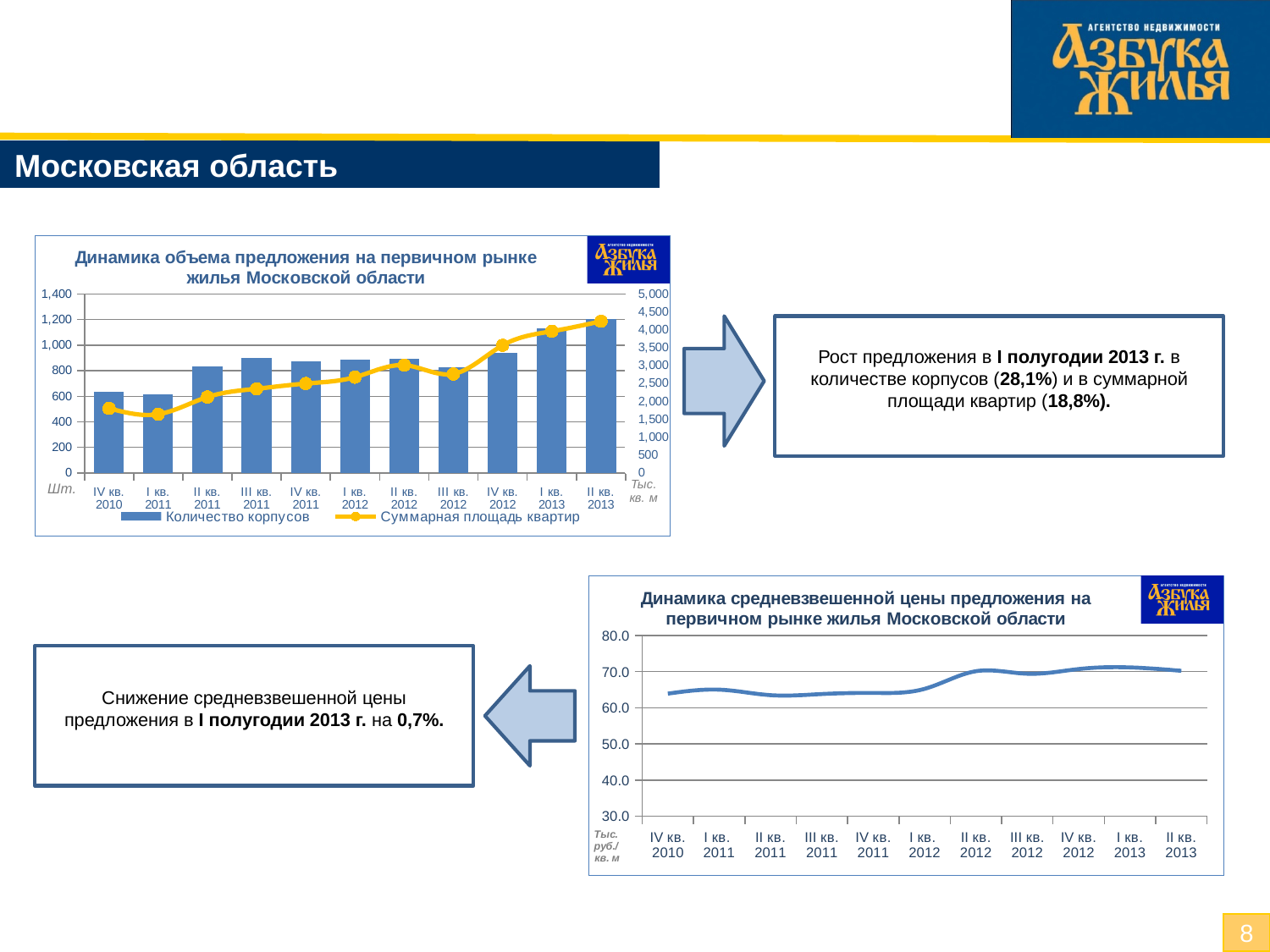
In the top-left chart 'Динамика объема предложения на первичном рынке жилья Московской области', is the 'Количество корпусов' bar for IV кв. 2010 greater or less than 800? less In the bottom-right chart 'Динамика средневзвешенной цены предложения на первичном рынке жилья Московской области', does the line overall rise or fall from IV кв. 2010 to II кв. 2013? rise In the bottom-right chart 'Динамика средневзвешенной цены предложения на первичном рынке жилья Московской области', how many quarters are shown on the x axis? 11 In the top-left chart 'Динамика объема предложения на первичном рынке жилья Московской области', which series is drawn as a line with markers? Суммарная площадь квартир In the top-left chart 'Динамика объема предложения на первичном рынке жилья Московской области', is the 'Суммарная площадь квартир' value for II кв. 2013 greater or less than 4,000? greater In the top-left chart 'Динамика объема предложения на первичном рынке жилья Московской области', which quarter has the highest bar for 'Количество корпусов'? II кв. 2013 In the top-left chart 'Динамика объема предложения на первичном рынке жилья Московской области', how many quarters are shown on the x axis? 11 In the bottom-right chart 'Динамика средневзвешенной цены предложения на первичном рынке жилья Московской области', is the value for I кв. 2013 greater or less than 70.0? greater In the top-left chart 'Динамика объема предложения на первичном рынке жилья Московской области', how many series does the legend list? 2 What type of chart is the bottom-right chart 'Динамика средневзвешенной цены предложения на первичном рынке жилья Московской области'? line chart In the top-left chart 'Динамика объема предложения на первичном рынке жилья Московской области', which is larger for 'Количество корпусов': IV кв. 2010 or II кв. 2013? II кв. 2013